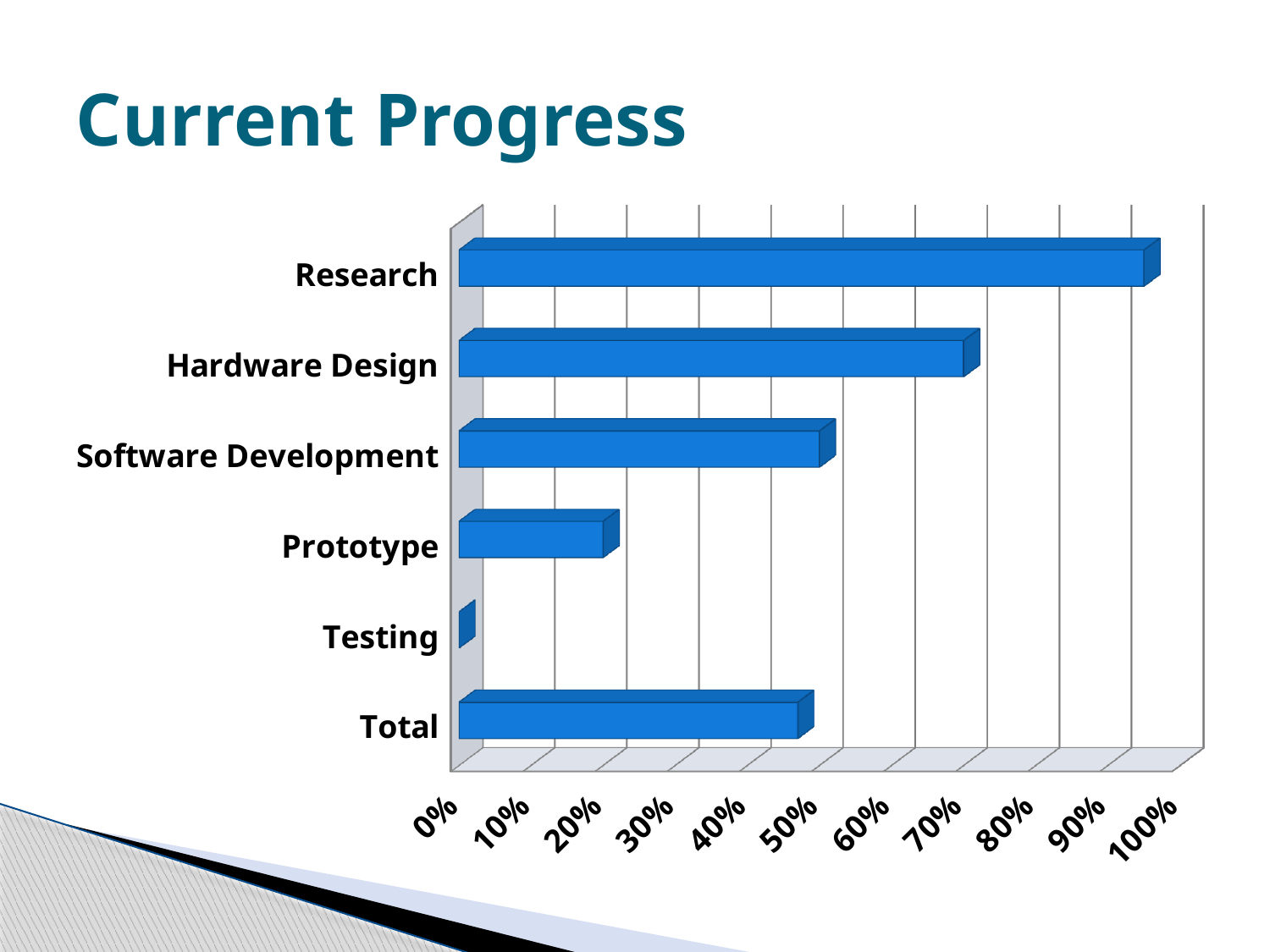
Is the value for Research greater or less than 80%? greater Is the value for Hardware Design greater or less than 60%? greater Which is larger, the value for Hardware Design or the value for Software Development? Hardware Design Is the value for Prototype greater or less than 30%? less Which is larger, the value for Prototype or the value for Testing? Prototype Which category has the lowest value? Testing What kind of chart is shown on the slide? Bar chart What is the title of the slide containing the chart? Current Progress Which category has the highest value? Research How many categories are plotted on the chart? 6